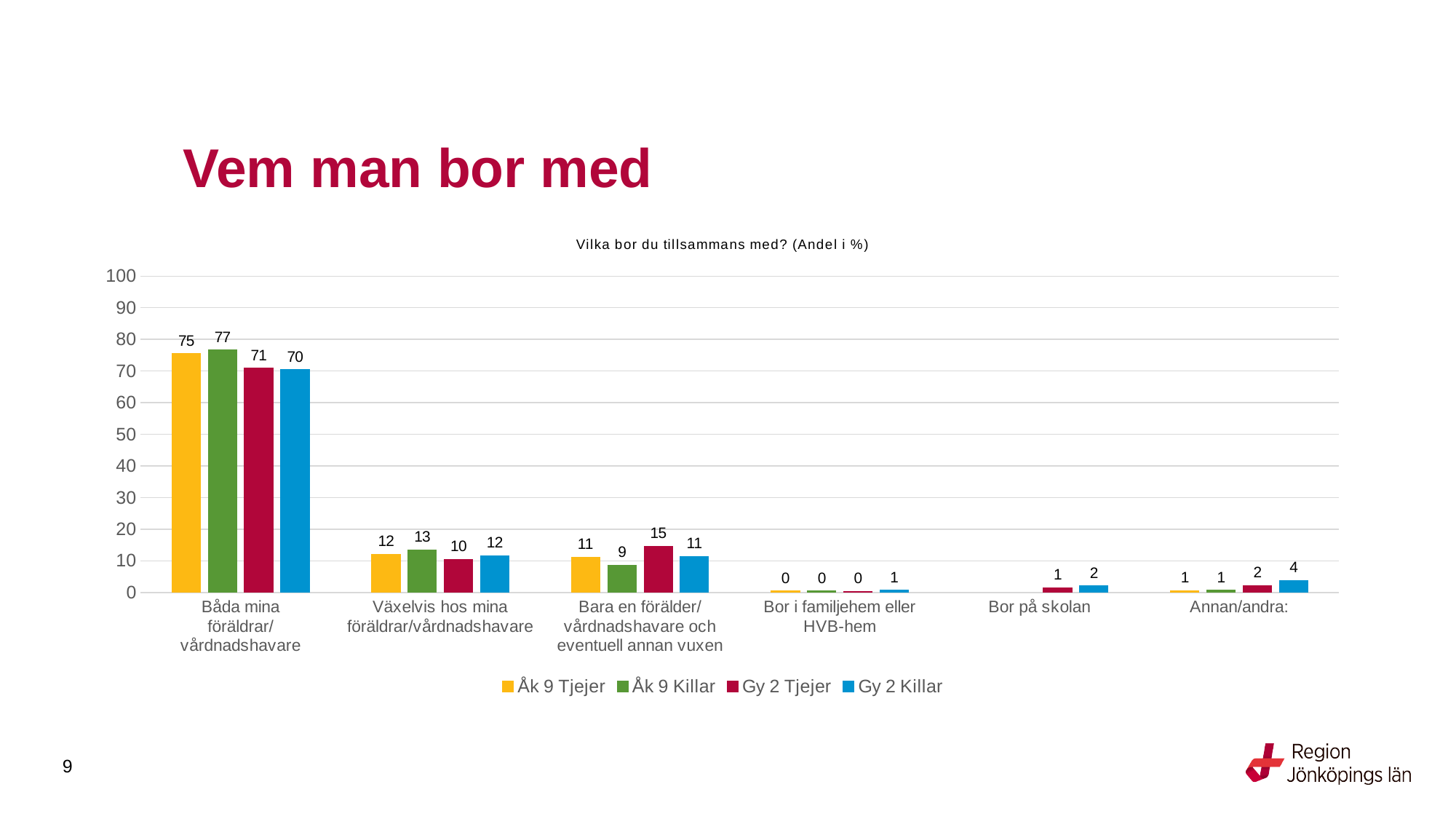
Which is larger in the category 'Bara en förälder/vårdnadshavare och eventuell annan vuxen': the value for Åk 9 Killar or for Gy 2 Tjejer? Gy 2 Tjejer What is the value for Gy 2 Killar in the category 'Annan/andra:'? 4 Which series has the lowest value in the category 'Växelvis hos mina föräldrar/vårdnadshavare'? Gy 2 Tjejer What is the value for Åk 9 Killar in the category 'Båda mina föräldrar/vårdnadshavare'? 77 What is the difference between the Åk 9 Killar and Gy 2 Killar values in the category 'Båda mina föräldrar/vårdnadshavare'? 7 What type of chart is shown on the slide? bar chart What is the value for Gy 2 Tjejer in the category 'Bara en förälder/vårdnadshavare och eventuell annan vuxen'? 15 How many series does the legend list? 4 Is the value for Gy 2 Tjejer in the category 'Båda mina föräldrar/vårdnadshavare' greater or less than 60? greater Which series has the highest value in the category 'Båda mina föräldrar/vårdnadshavare'? Åk 9 Killar What is the title of the chart? Vilka bor du tillsammans med? (Andel i %) How many categories are shown on the x axis? 6